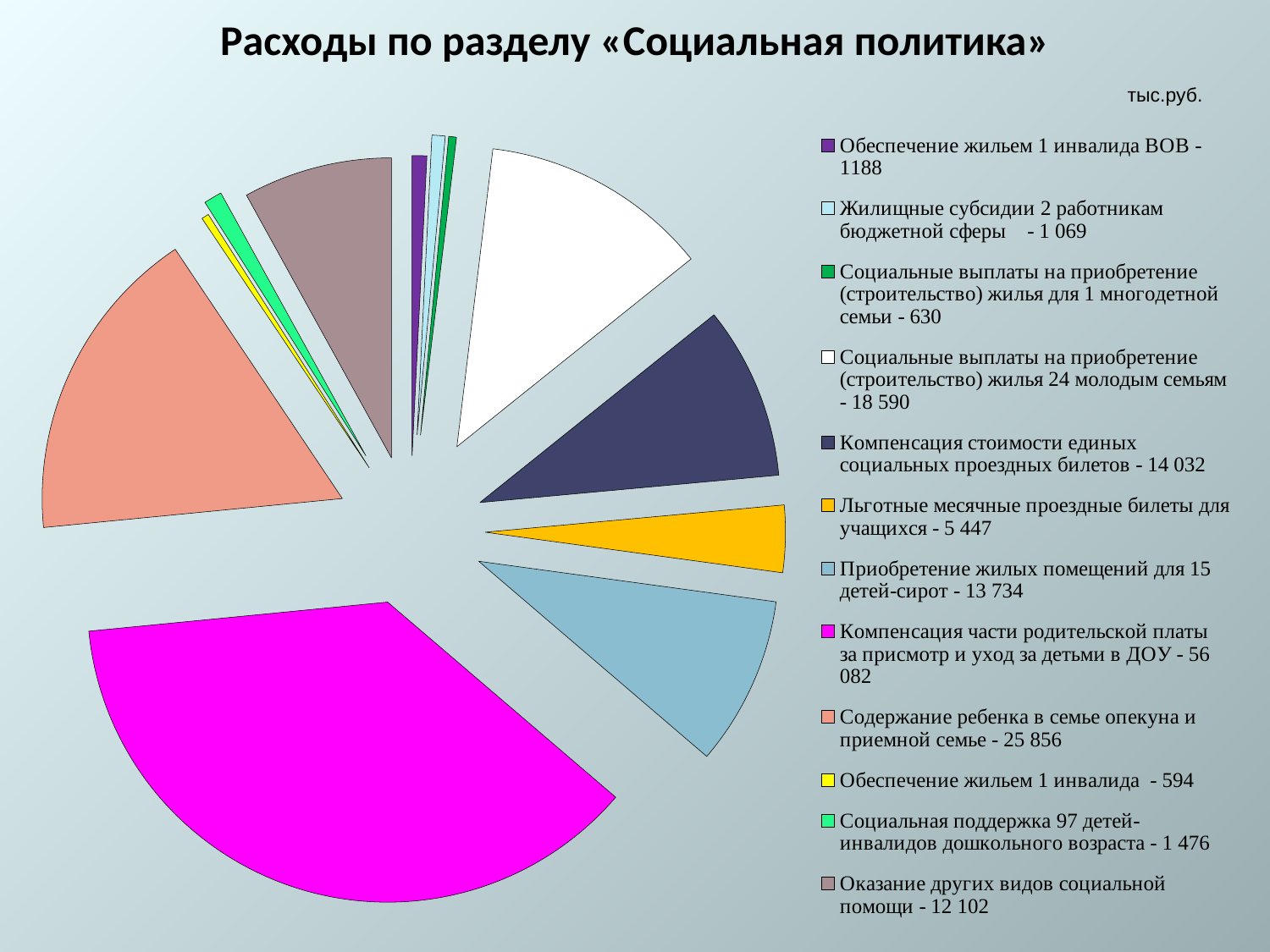
What is the value for «Льготные месячные проездные билеты для учащихся»? 5 447 What is the value for «Компенсация части родительской платы за присмотр и уход за детьми в ДОУ»? 56 082 In what units are the values given? тыс.руб. Which category has the smallest expenditure? Обеспечение жильем 1 инвалида What is the title of the chart? Расходы по разделу «Социальная политика» Which is larger: «Компенсация стоимости единых социальных проездных билетов» or «Оказание других видов социальной помощи»? Компенсация стоимости единых социальных проездных билетов How many categories does the pie chart have? 12 What is the difference between «Содержание ребенка в семье опекуна и приемной семье» and «Социальные выплаты на приобретение (строительство) жилья 24 молодым семьям»? 7 266 What type of chart is shown on the slide? Pie chart Which category has the largest expenditure? Компенсация части родительской платы за присмотр и уход за детьми в ДОУ What is the value for «Содержание ребенка в семье опекуна и приемной семье»? 25 856 What is the value for «Социальная поддержка 97 детей-инвалидов дошкольного возраста»? 1 476